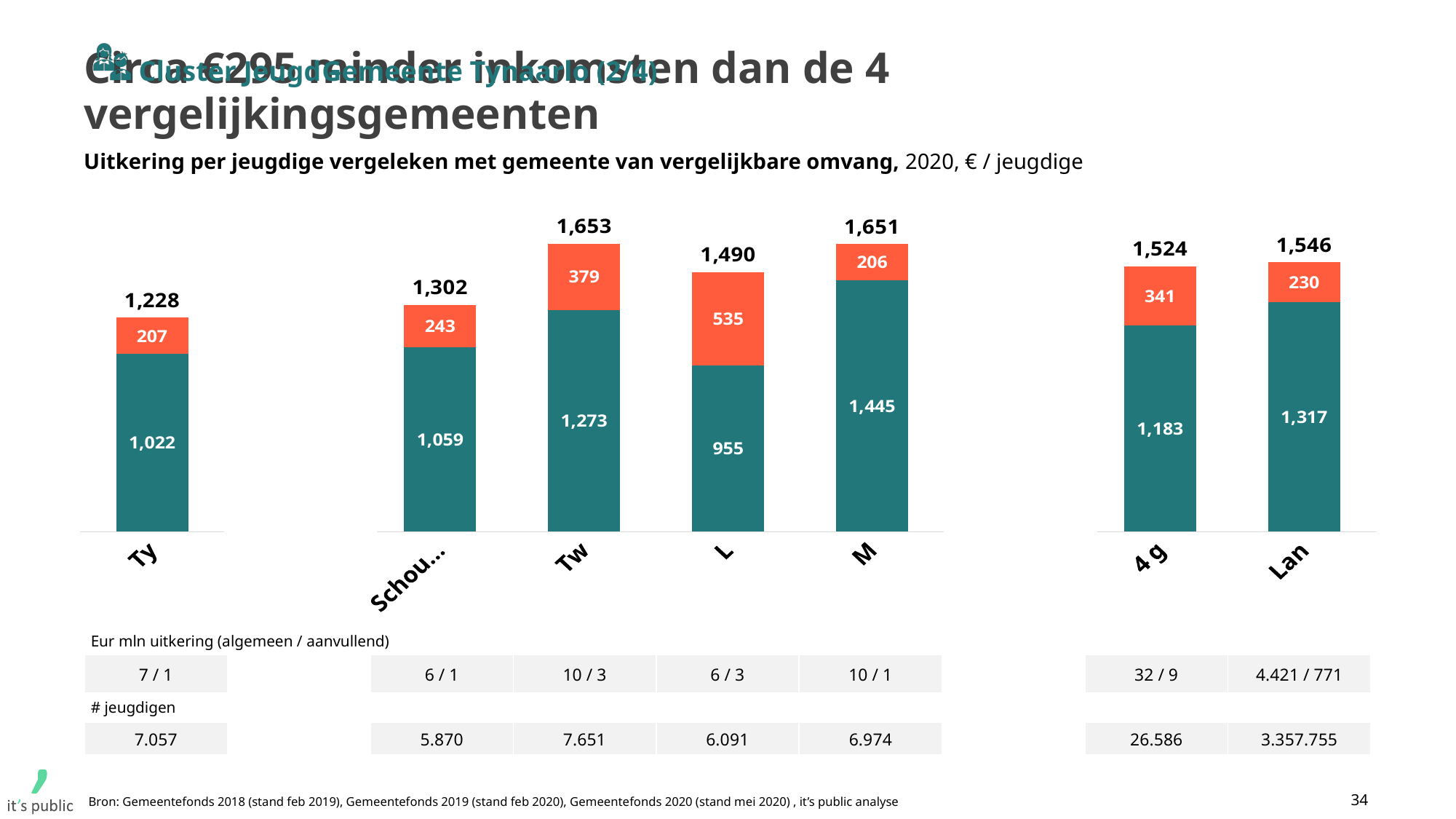
How many bars are plotted in the chart? 7 Which category has the largest orange (top) segment? L What is the total value shown above the bar for Ty? 1,228 What is the difference between the total for Tw and the total for Ty? 425 What kind of chart is shown on the slide? Stacked bar chart What is the value of the teal (bottom) segment of the bar for M? 1,445 What is the value of the orange (top) segment of the bar for L? 535 What is the total value shown above the bar for Lan? 1,546 Which category has the lowest total value? Ty Which category has the smallest teal (bottom) segment? L What unit is stated in the chart subtitle for the values? € / jeugdige Which has a larger total value, 4 g or Lan? Lan